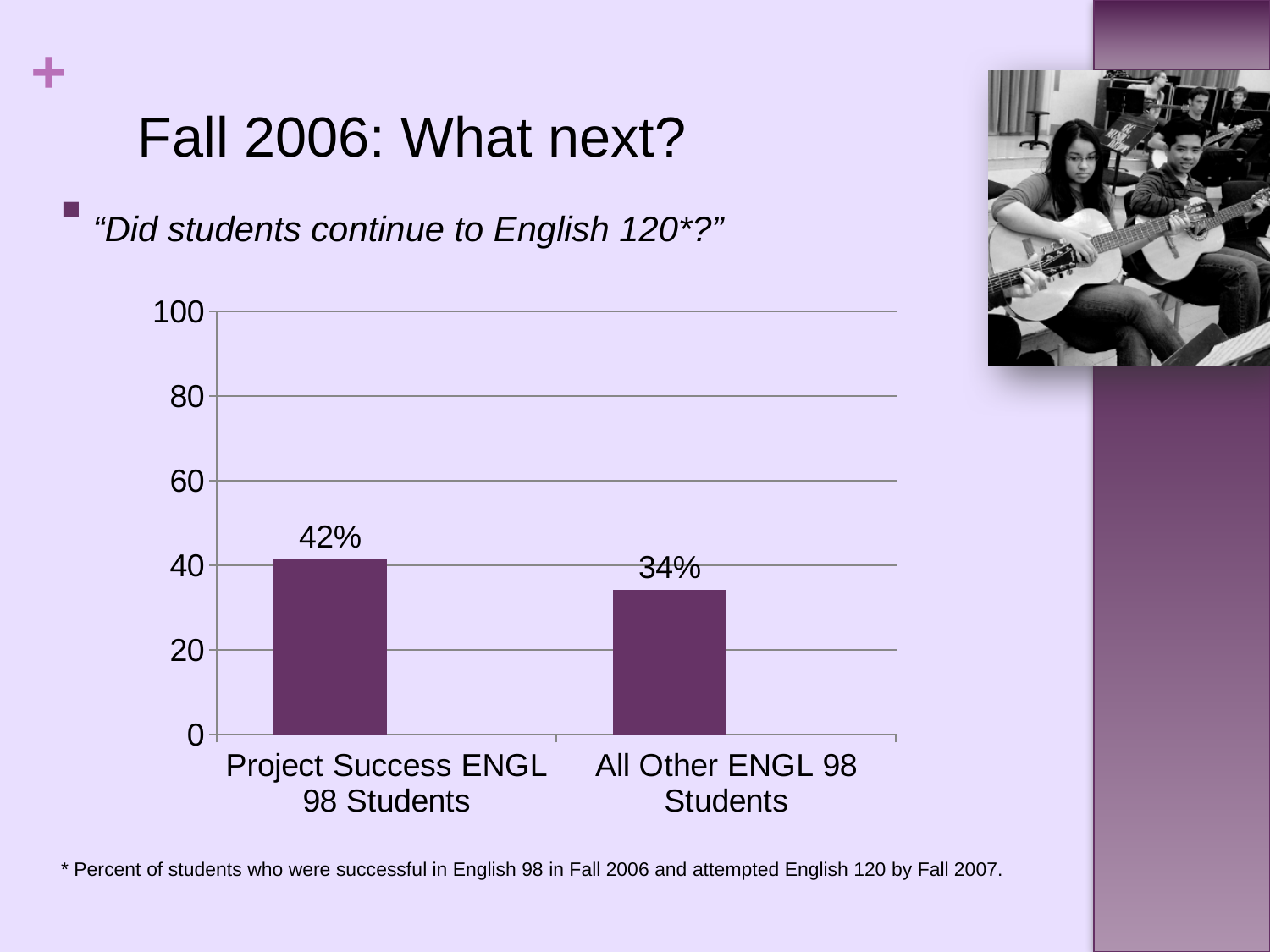
What is the value for Project Success ENGL 98 Students? 42% What is the value for All Other ENGL 98 Students? 34% What is the highest value shown on the vertical axis of the chart? 100 Which is larger, the value for Project Success ENGL 98 Students or the value for All Other ENGL 98 Students? Project Success ENGL 98 Students Is the value for Project Success ENGL 98 Students greater or less than 40? greater Which category has the lowest value? All Other ENGL 98 Students What question does the slide pose above the chart? "Did students continue to English 120*?" Is the value for All Other ENGL 98 Students greater or less than 40? less What is the difference between the values for Project Success ENGL 98 Students and All Other ENGL 98 Students? 8% What kind of chart is shown on the slide? Bar chart Which category has the highest value? Project Success ENGL 98 Students How many categories are shown in the chart? 2